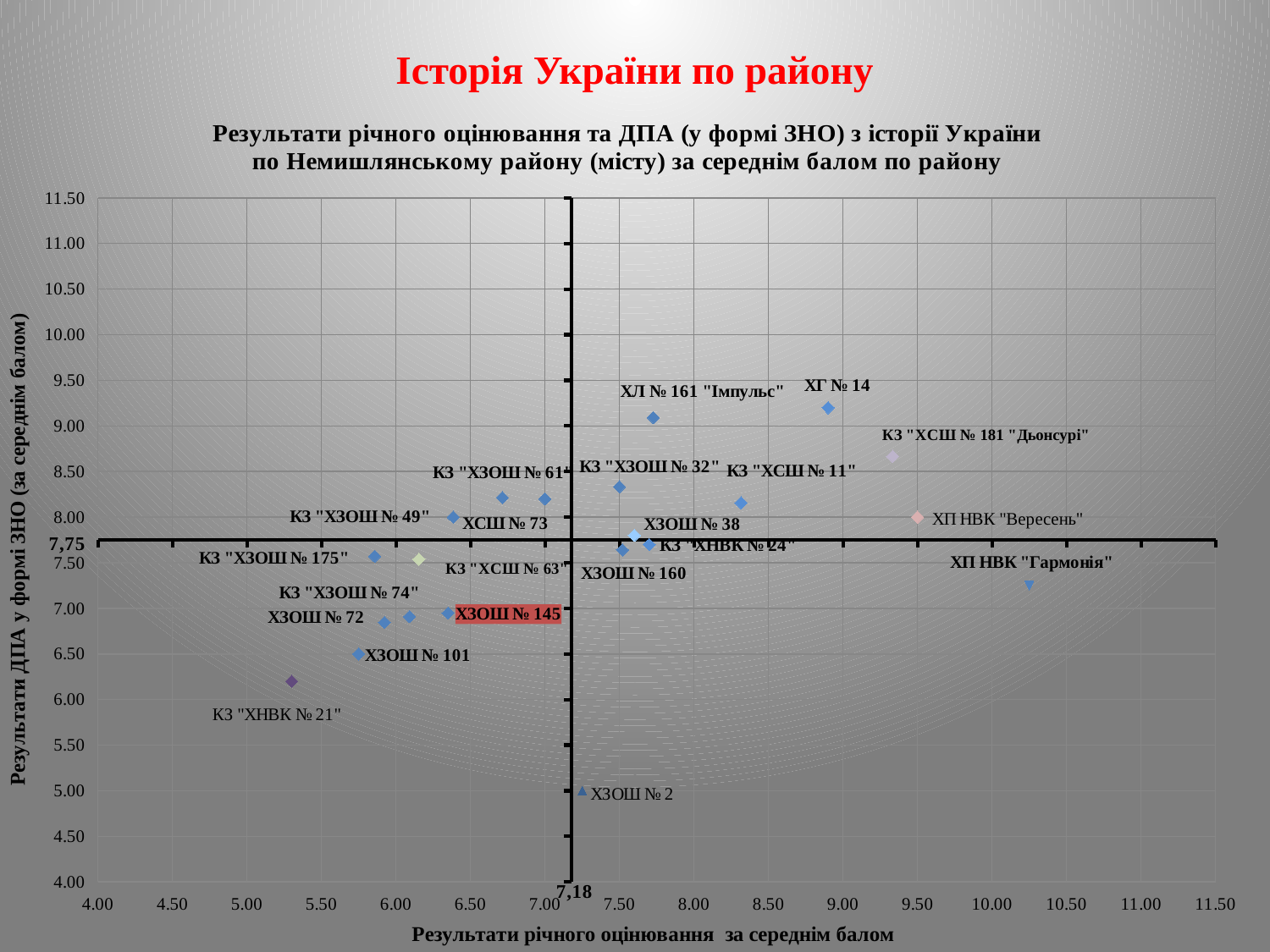
Which school has the highest annual assessment result (x axis) on the chart? ХП НВК "Гармонія" Which has the higher ДПА result (y axis): ХП НВК "Вересень" or ХП НВК "Гармонія"? ХП НВК "Вересень" What is the title of the x axis of the chart? Результати річного оцінювання за середнім балом Is the ДПА result (y axis) for ХГ № 14 greater or less than 9.00? greater Which has the higher annual assessment result (x axis): КЗ "ХСШ № 181 "Дьонсурі" or ХЛ № 161 "Імпульс"? КЗ "ХСШ № 181 "Дьонсурі" Which school has the lowest annual assessment result (x axis) on the chart? КЗ "ХНВК № 21" Is the annual assessment result (x axis) for ХП НВК "Гармонія" greater or less than 10.00? greater What value is printed on the y axis where the horizontal reference line crosses it? 7,75 Which school has the lowest ДПА result (y axis) on the chart? ХЗОШ № 2 What value is printed on the x axis where the vertical reference line crosses it? 7,18 Is the ДПА result (y axis) for ХЗОШ № 101 greater or less than 7.00? less What kind of chart is shown on the slide? scatter chart